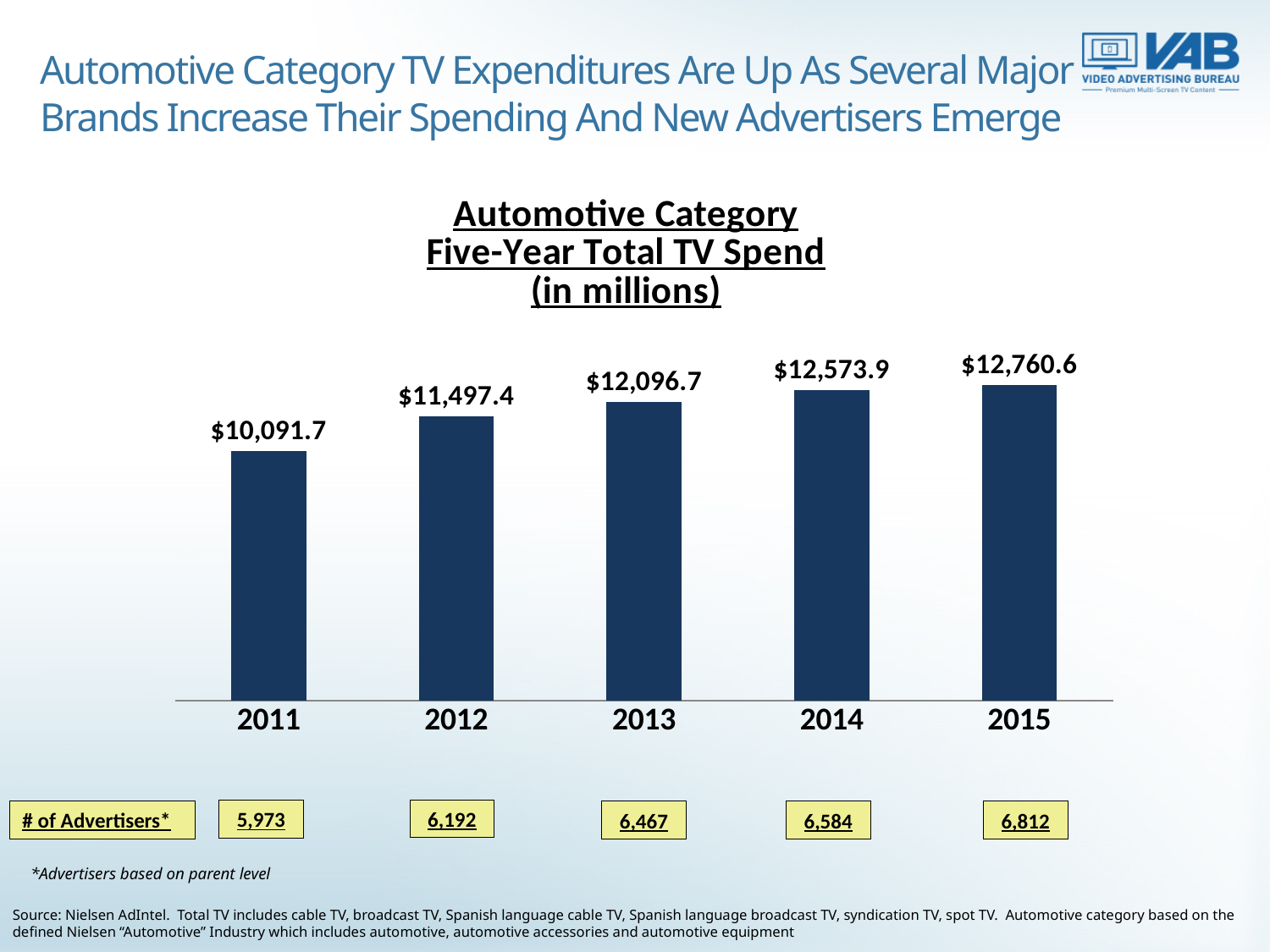
Which year had the highest total TV spend? 2015 What is the difference in total TV spend between 2012 and 2011? $1,405.7 What was the automotive category total TV spend in 2015? $12,760.6 What is the difference in total TV spend between 2015 and 2011? $2,668.9 What was the automotive category total TV spend in 2011? $10,091.7 Which year had the lowest total TV spend? 2011 What was the automotive category total TV spend in 2013? $12,096.7 Which year had a larger total TV spend, 2012 or 2014? 2014 How many years are shown in the chart? 5 Does the total TV spend rise or fall from 2011 to 2015? Rise What type of chart is used to show the five-year total TV spend? Bar chart What is the difference in total TV spend between 2014 and 2013? $477.2